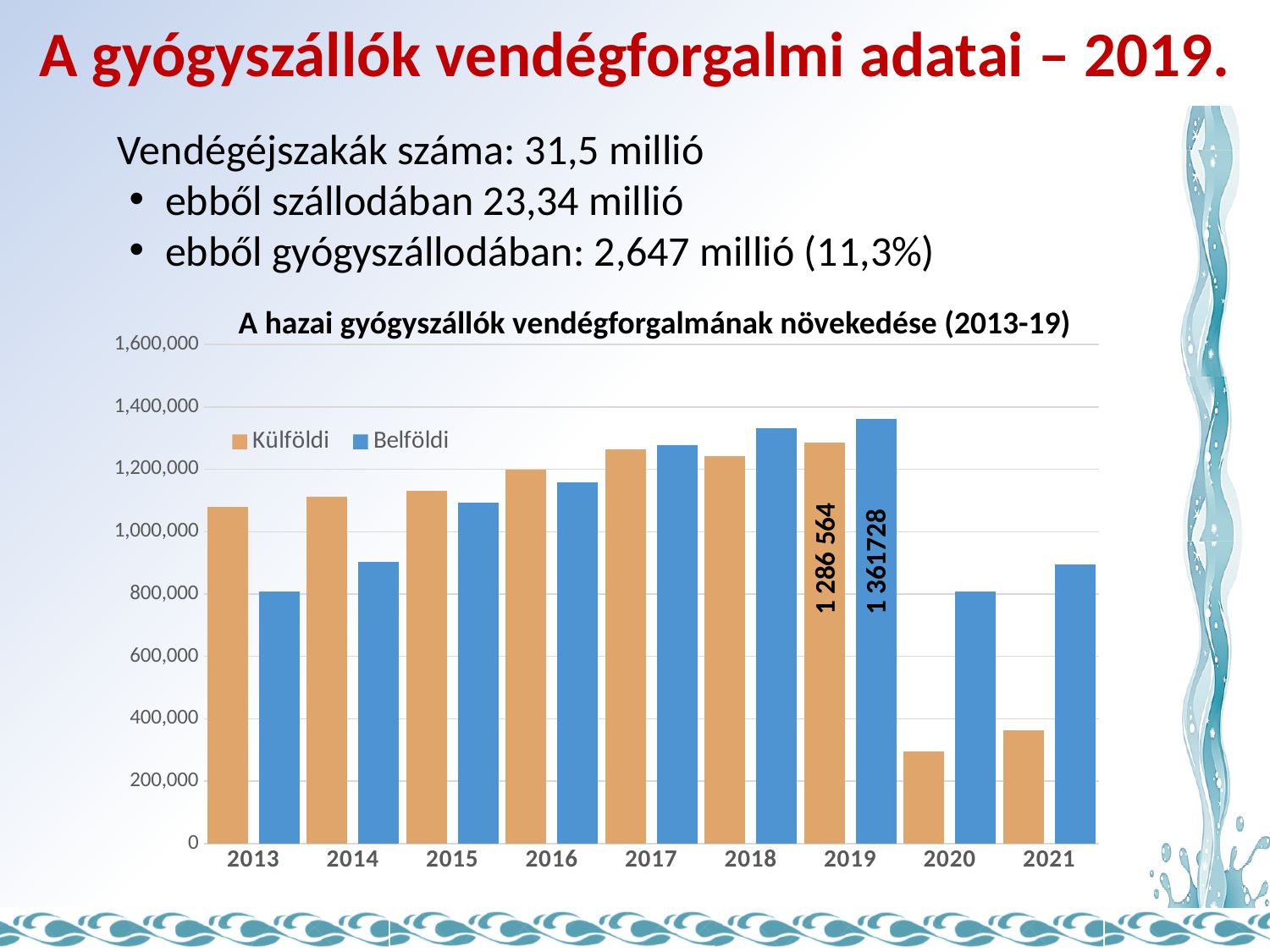
Is the Külföldi value for 2020 greater or less than 400,000? less What is the value for Belföldi in 2019? 1 361728 In which year is the Belföldi value highest? 2019 What is the value for Külföldi in 2019? 1 286 564 Is the Külföldi value for 2016 greater or less than 1,000,000? greater How many series does the chart's legend list? 2 How many years are shown on the x axis of the chart? 9 In which year is the Külföldi value lowest? 2020 In 2013, which series has the larger value, Külföldi or Belföldi? Külföldi Is the Belföldi value for 2021 greater or less than 1,000,000? less In 2019, which series has the larger value, Külföldi or Belföldi? Belföldi What kind of chart is shown on the slide? Bar chart